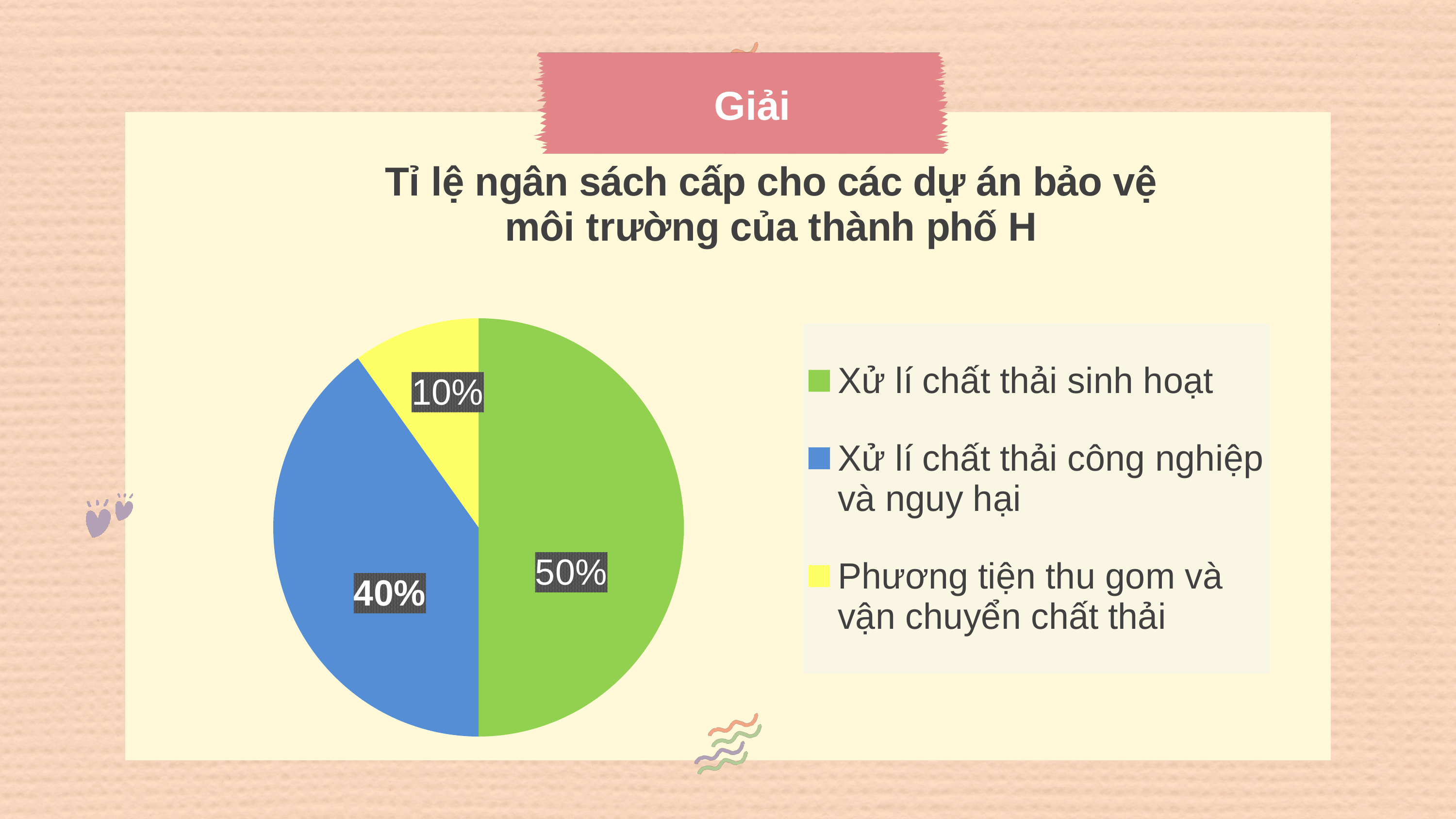
What is the difference in percentage points between Xử lí chất thải sinh hoạt and Xử lí chất thải công nghiệp và nguy hại? 10% What percentage of the budget goes to Phương tiện thu gom và vận chuyển chất thải? 10% How many categories does the pie chart show? 3 Which is larger: the share for Xử lí chất thải công nghiệp và nguy hại or the share for Phương tiện thu gom và vận chuyển chất thải? Xử lí chất thải công nghiệp và nguy hại What is the difference in percentage points between Xử lí chất thải công nghiệp và nguy hại and Phương tiện thu gom và vận chuyển chất thải? 30% What colour is the slice for Phương tiện thu gom và vận chuyển chất thải? Yellow What is the title of the chart? Tỉ lệ ngân sách cấp cho các dự án bảo vệ môi trường của thành phố H Which category receives the smallest share of the budget? Phương tiện thu gom và vận chuyển chất thải What percentage of the budget goes to Xử lí chất thải sinh hoạt? 50% What kind of chart is shown on the slide? Pie chart Which category receives the largest share of the budget? Xử lí chất thải sinh hoạt What percentage of the budget goes to Xử lí chất thải công nghiệp và nguy hại? 40%